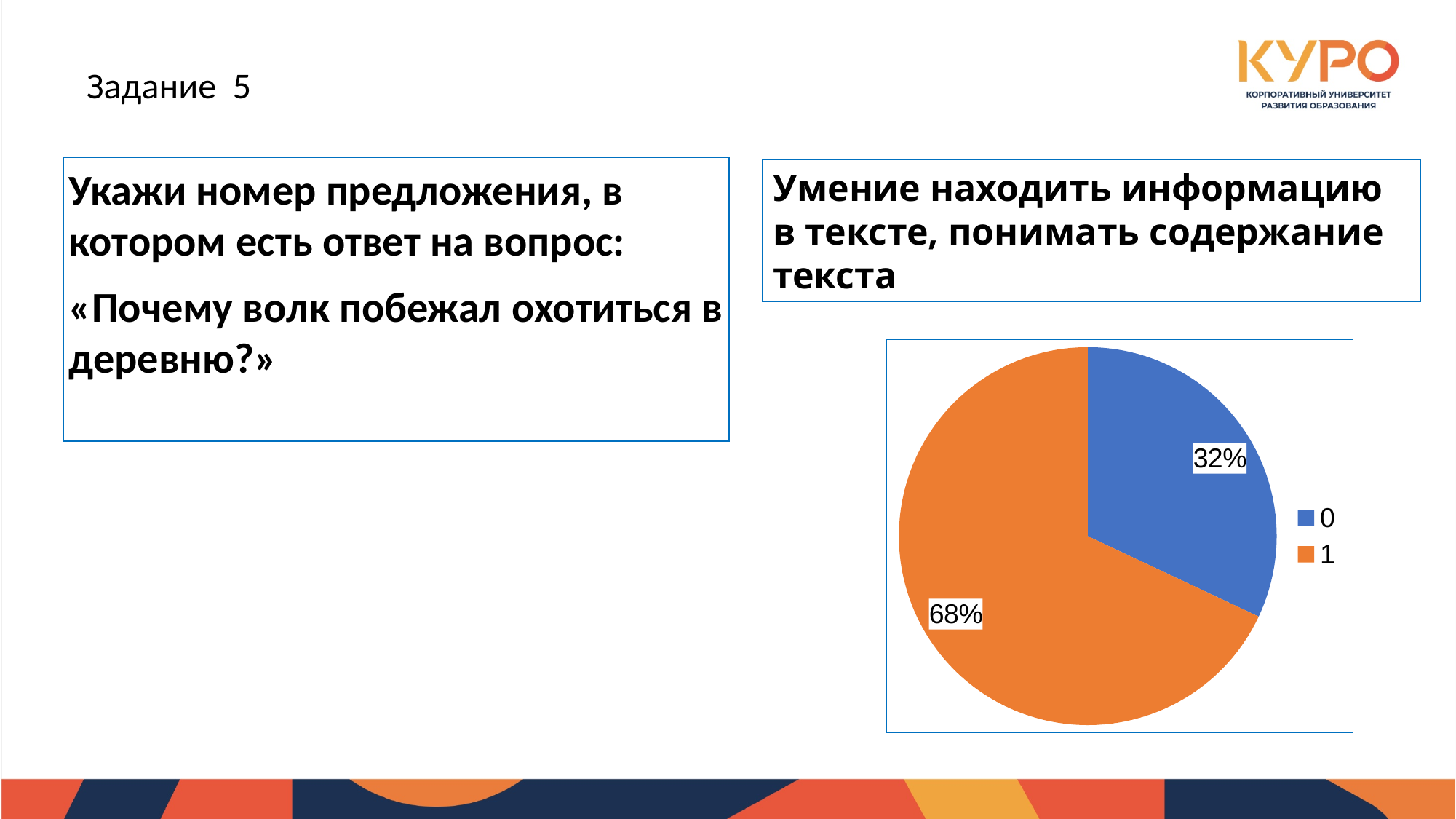
What colour is the slice for category 1? orange How many slices does the pie chart have? 2 What share of the pie does category 0 have? 32% What share of the pie does category 1 have? 68% What kind of chart is shown on the slide? pie chart How many entries does the legend list? 2 Which category has the smallest slice of the pie? 0 What is the difference in percentage points between the slices for category 1 and category 0? 36 Which slice is larger, category 0 or category 1? 1 Which category has the largest slice of the pie? 1 What colour is the slice for category 0? blue